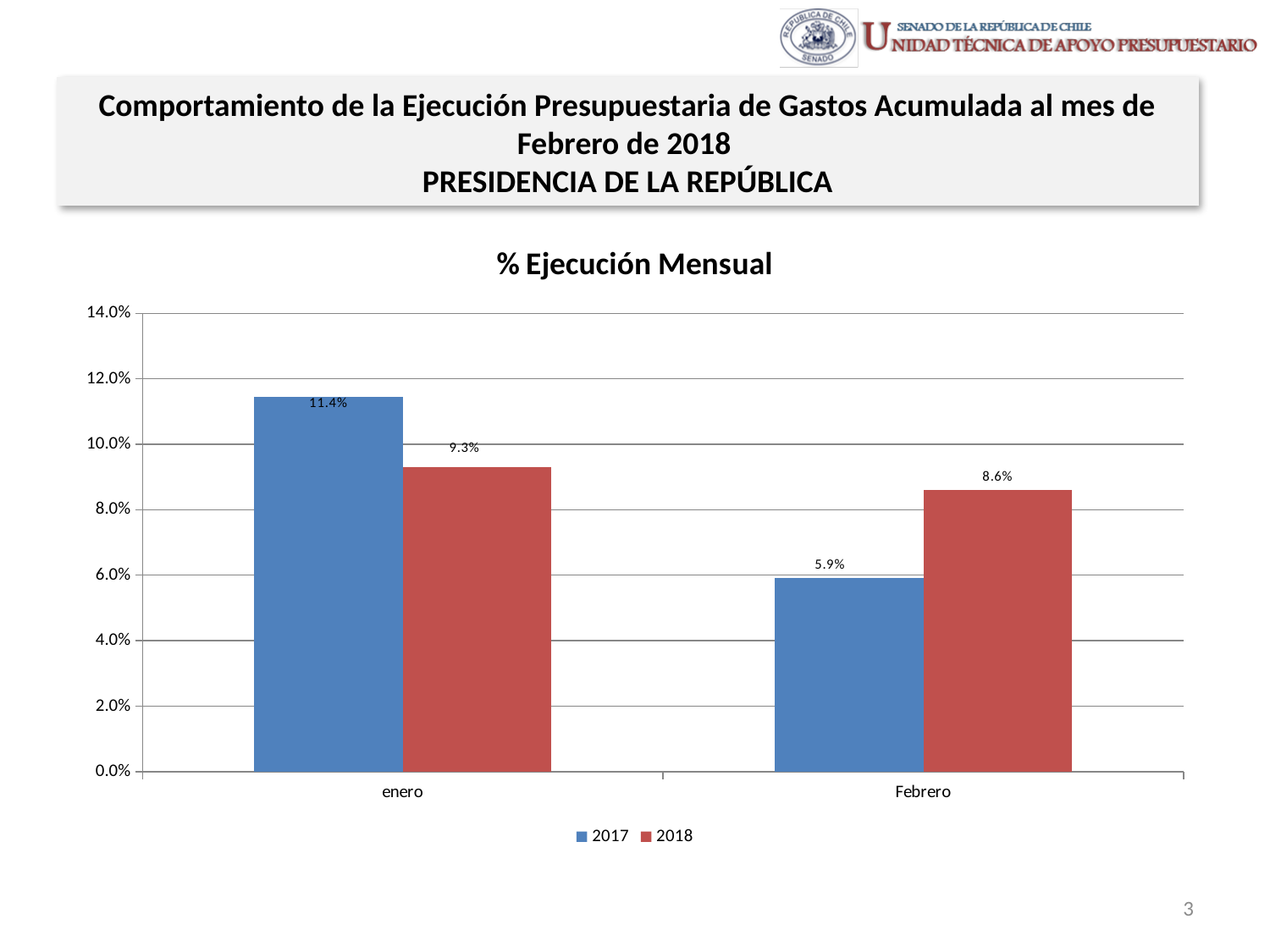
What is the value for 2018 in Febrero? 8.6% What kind of chart is shown on the slide? Bar chart Which month has the lowest value for the 2018 series? Febrero What is the value for 2017 in Febrero? 5.9% In Febrero, which series has the larger value, 2017 or 2018? 2018 What is the difference between the 2018 and 2017 values in Febrero? 2.7% What is the value for 2018 in enero? 9.3% How many series does the legend list? 2 What is the difference between the 2017 and 2018 values in enero? 2.1% What is the value for 2017 in enero? 11.4% Which month has the highest value for the 2017 series? enero What is the title of the chart? % Ejecución Mensual